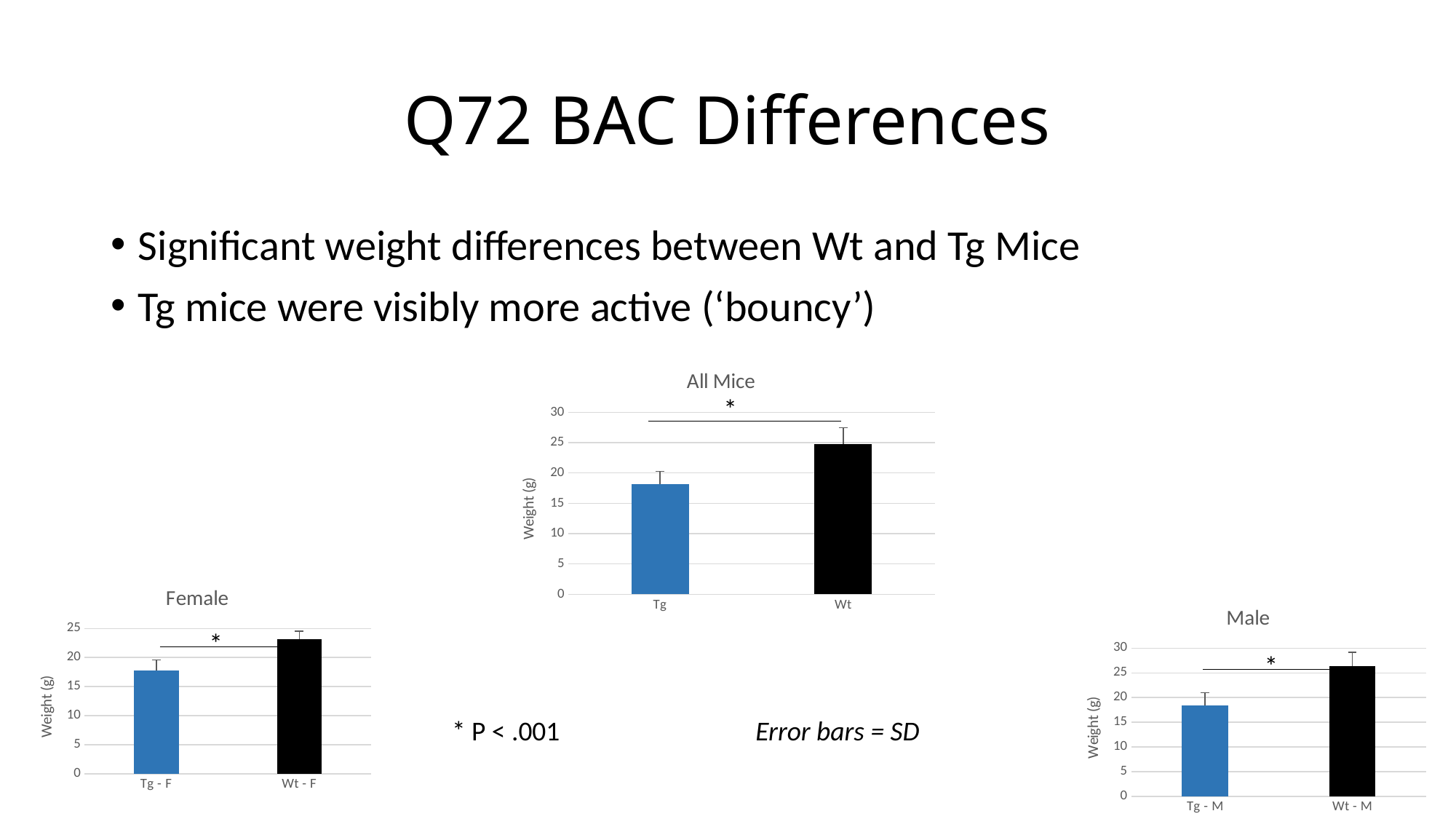
In the 'Female' chart, which category has the lower weight, Tg - F or Wt - F? Tg - F What kind of chart is the 'Female' chart? bar chart In the 'All Mice' chart, is the value for Tg greater or less than 20? less In the 'Male' chart, is the value for Tg - M greater or less than 20? less In the 'Female' chart, is the value for Wt - F greater or less than 20? greater In the 'All Mice' chart, which category has the higher weight, Tg or Wt? Wt In the 'Male' chart, which category has the highest weight? Wt - M How many categories are shown in the 'All Mice' chart? 2 What is the y-axis label on the 'Male' chart? Weight (g)